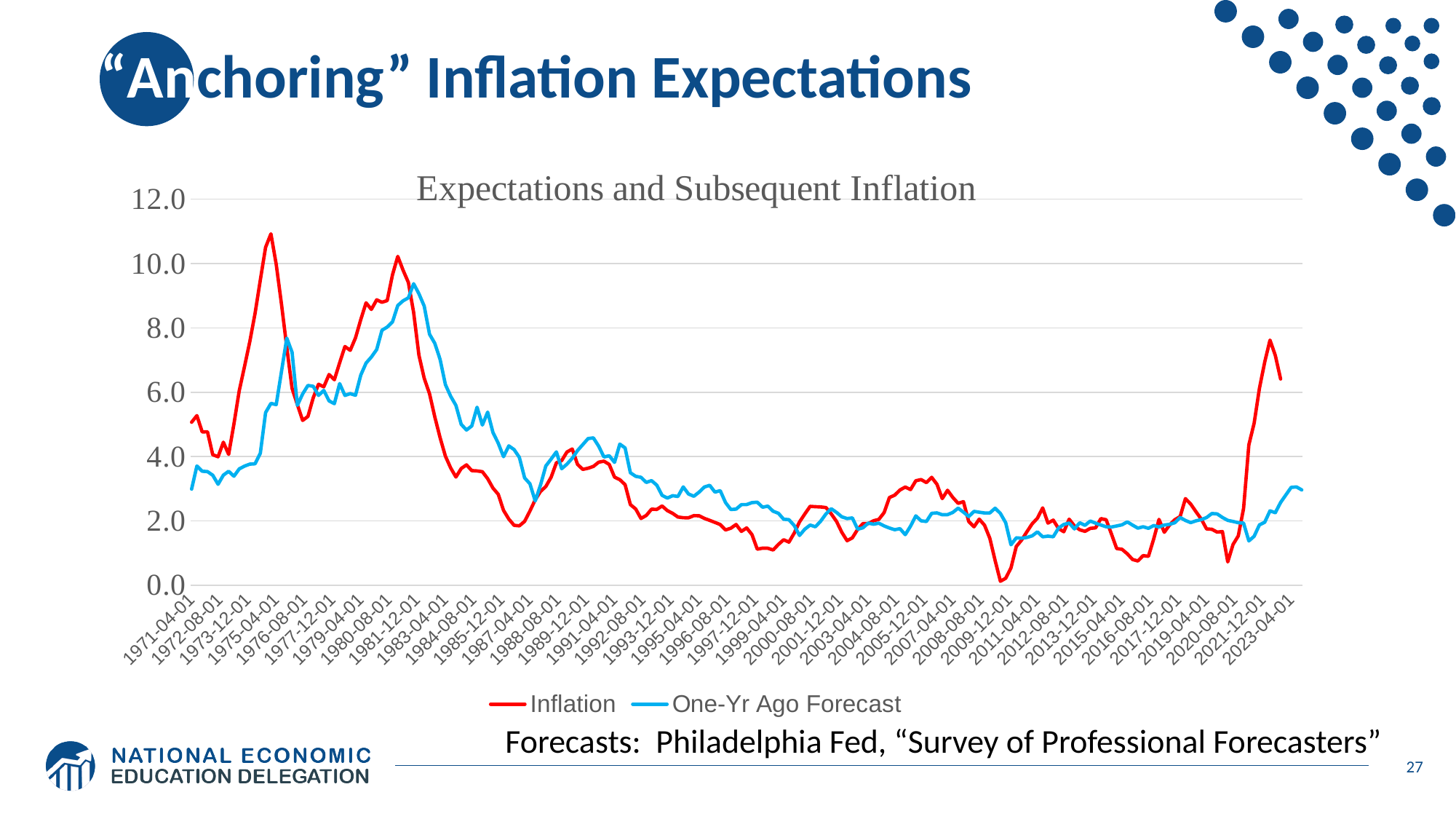
Which series reaches the highest peak on the chart? Inflation Does the Inflation series generally rise or fall between 1981-12-01 and 1987-04-01? fall How many series does the legend list? 2 Around 2009-12-01, which series has the higher value, Inflation or One-Yr Ago Forecast? One-Yr Ago Forecast Is the One-Yr Ago Forecast value around 1981-12-01 greater or less than 8.0? greater Is the Inflation value around 2009-12-01 greater or less than 2.0? less Is the Inflation value around 2021-12-01 greater or less than 6.0? greater What kind of chart is shown on the slide? line chart Around 1975-04-01, which series has the higher value, Inflation or One-Yr Ago Forecast? Inflation What is the title of the chart? Expectations and Subsequent Inflation Which colour is used for the One-Yr Ago Forecast series? blue